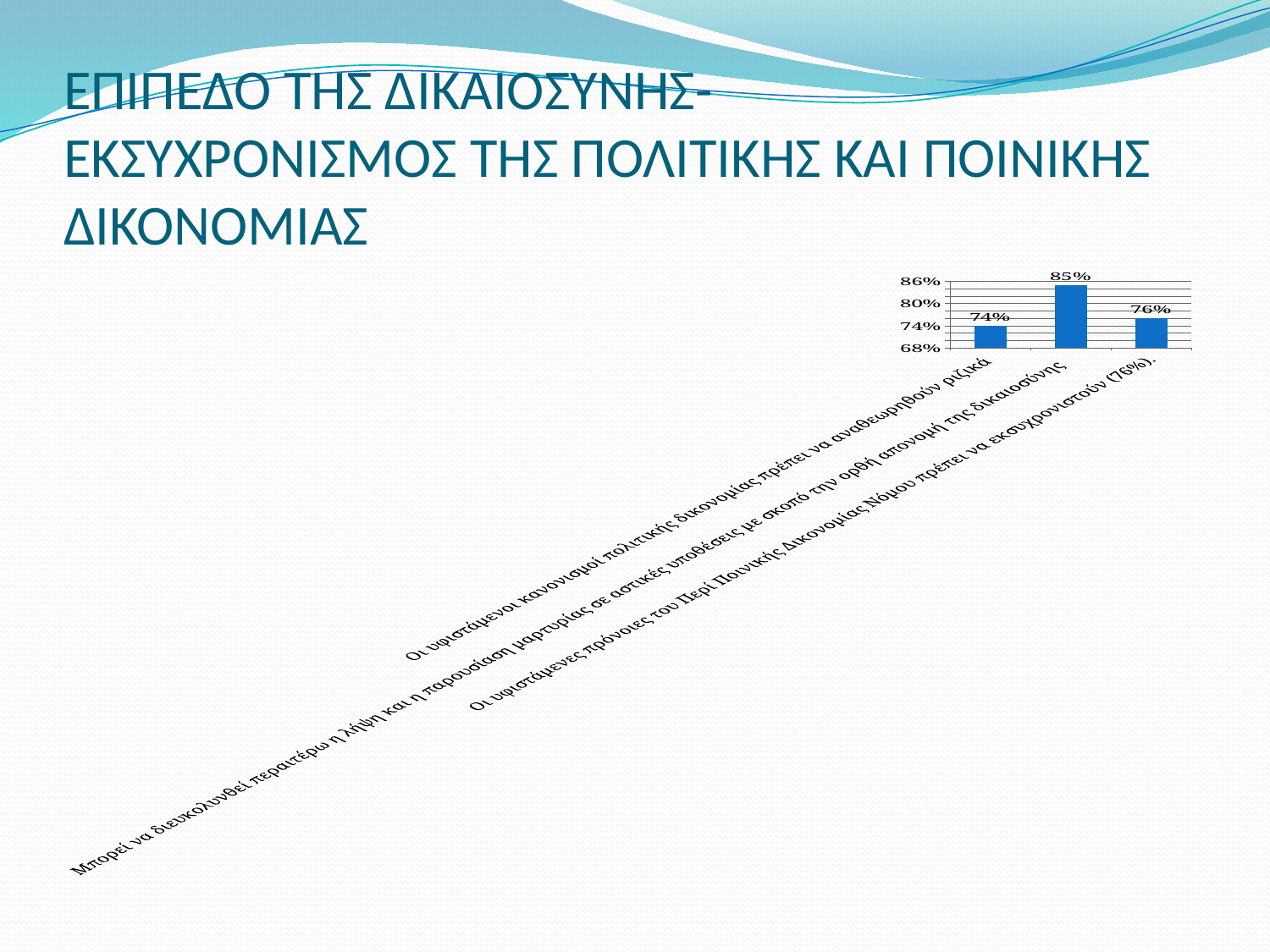
What is the value for the category "Οι υφιστάμενες πρόνοιες του Περί Ποινικής Δικονομίας Νόμου πρέπει να εκσυγχρονιστούν"? 76% Which category has the highest value? Μπορεί να διευκολυνθεί περαιτέρω η λήψη και η παρουσίαση μαρτυρίας σε αστικές υποθέσεις με σκοπό την ορθή απονομή της δικαιοσύνης What is the highest value shown on the vertical axis of the chart? 86% What is the value for the category "Οι υφιστάμενοι κανονισμοί πολιτικής δικονομίας πρέπει να αναθεωρηθούν ριζικά"? 74% Is the value for "Μπορεί να διευκολυνθεί περαιτέρω η λήψη και η παρουσίαση μαρτυρίας σε αστικές υποθέσεις με σκοπό την ορθή απονομή της δικαιοσύνης" greater or less than 80%? greater What kind of chart is shown on the slide? bar chart Which category has the lowest value? Οι υφιστάμενοι κανονισμοί πολιτικής δικονομίας πρέπει να αναθεωρηθούν ριζικά Which is larger: the value for "Οι υφιστάμενες πρόνοιες του Περί Ποινικής Δικονομίας Νόμου πρέπει να εκσυγχρονιστούν" or the value for "Μπορεί να διευκολυνθεί περαιτέρω η λήψη και η παρουσίαση μαρτυρίας σε αστικές υποθέσεις με σκοπό την ορθή απονομή της δικαιοσύνης"? Μπορεί να διευκολυνθεί περαιτέρω η λήψη και η παρουσίαση μαρτυρίας σε αστικές υποθέσεις με σκοπό την ορθή απονομή της δικαιοσύνης What is the difference between the value for "Οι υφιστάμενες πρόνοιες του Περί Ποινικής Δικονομίας Νόμου πρέπει να εκσυγχρονιστούν" and the value for "Οι υφιστάμενοι κανονισμοί πολιτικής δικονομίας πρέπει να αναθεωρηθούν ριζικά"? 2% What is the value for the category "Μπορεί να διευκολυνθεί περαιτέρω η λήψη και η παρουσίαση μαρτυρίας σε αστικές υποθέσεις με σκοπό την ορθή απονομή της δικαιοσύνης"? 85% How many categories are shown in the chart? 3 What is the difference between the highest value (85%) and the lowest value (74%)? 11%